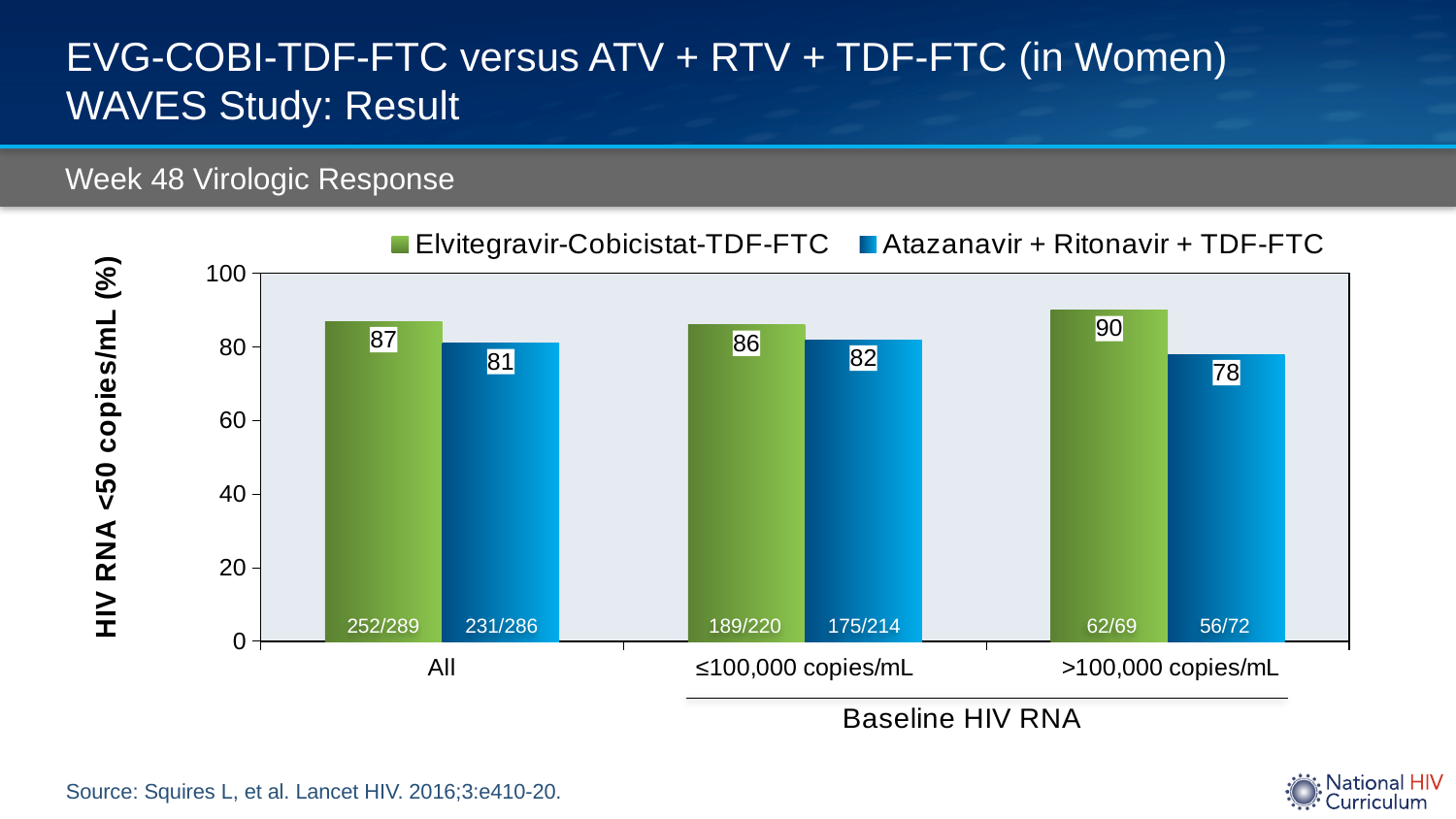
What is the value for Elvitegravir-Cobicistat-TDF-FTC in the All category? 87 What kind of chart is shown on the slide? Bar chart In the All category, which series has the larger value? Elvitegravir-Cobicistat-TDF-FTC Which category has the highest value for Elvitegravir-Cobicistat-TDF-FTC? >100,000 copies/mL What is the difference between the Elvitegravir-Cobicistat-TDF-FTC and Atazanavir + Ritonavir + TDF-FTC values in the >100,000 copies/mL category? 12 How many categories are shown on the x axis? 3 Is the value for Atazanavir + Ritonavir + TDF-FTC in the All category greater or less than 60? greater What is the value for Atazanavir + Ritonavir + TDF-FTC in the >100,000 copies/mL category? 78 What is the value for Atazanavir + Ritonavir + TDF-FTC in the ≤100,000 copies/mL category? 82 What is the label of the y axis? HIV RNA <50 copies/mL (%) How many series does the legend list? 2 Which category has the lowest value for Atazanavir + Ritonavir + TDF-FTC? >100,000 copies/mL